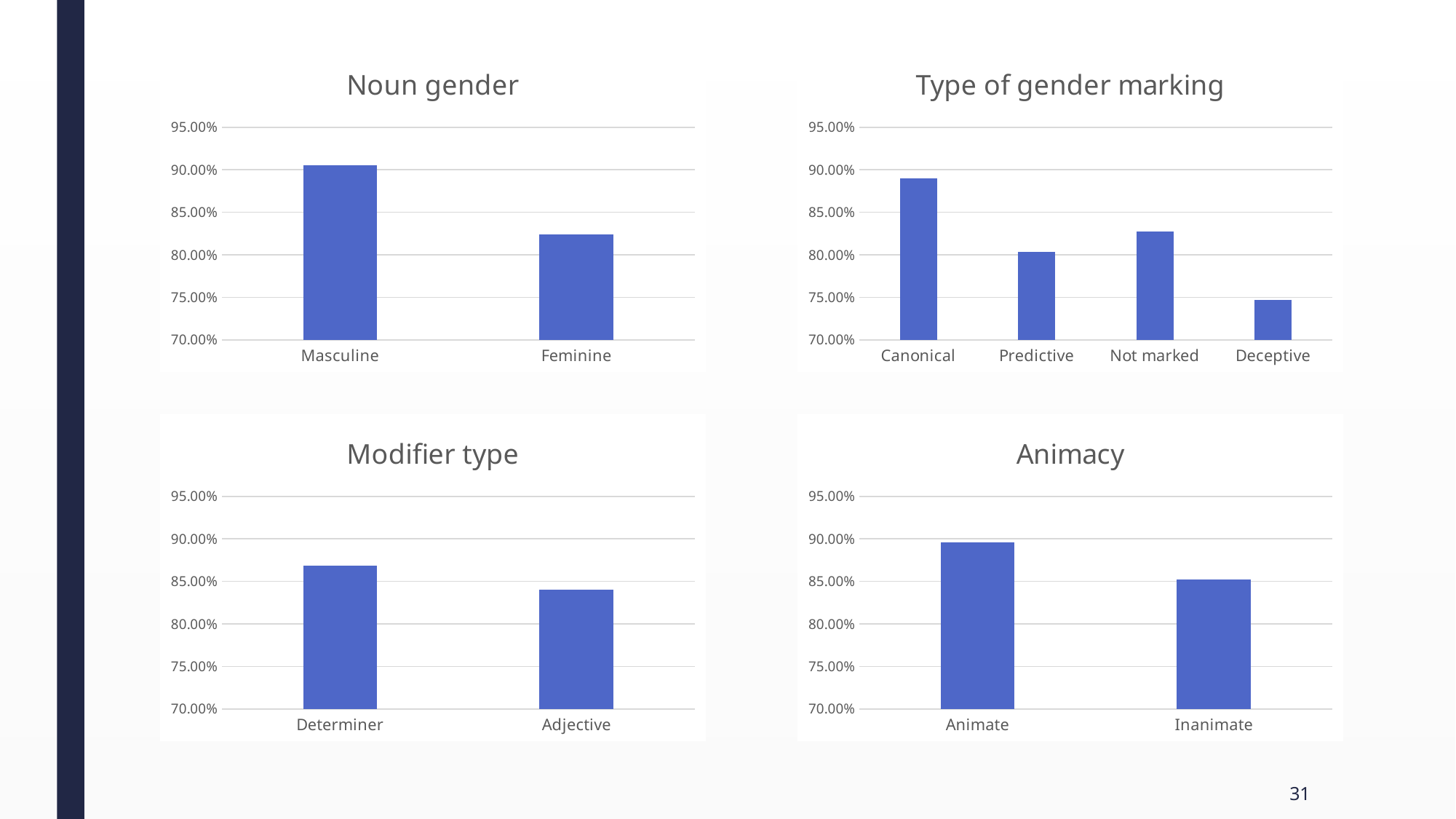
In the Noun gender chart, which category has the higher value? Masculine What kind of chart is the Animacy chart? bar chart In the Modifier type chart, which category has the higher value? Determiner In the Type of gender marking chart, how many categories are shown? 4 In the Type of gender marking chart, which is larger, Predictive or Not marked? Not marked In the Type of gender marking chart, is the value for Deceptive greater or less than 80.00%? less In the Animacy chart, which is larger, Animate or Inanimate? Animate In the Noun gender chart, is the value for Feminine greater or less than 85.00%? less In the Noun gender chart, is the value for Masculine greater or less than 85.00%? greater In the Type of gender marking chart, which category has the highest value? Canonical In the Type of gender marking chart, which category has the lowest value? Deceptive